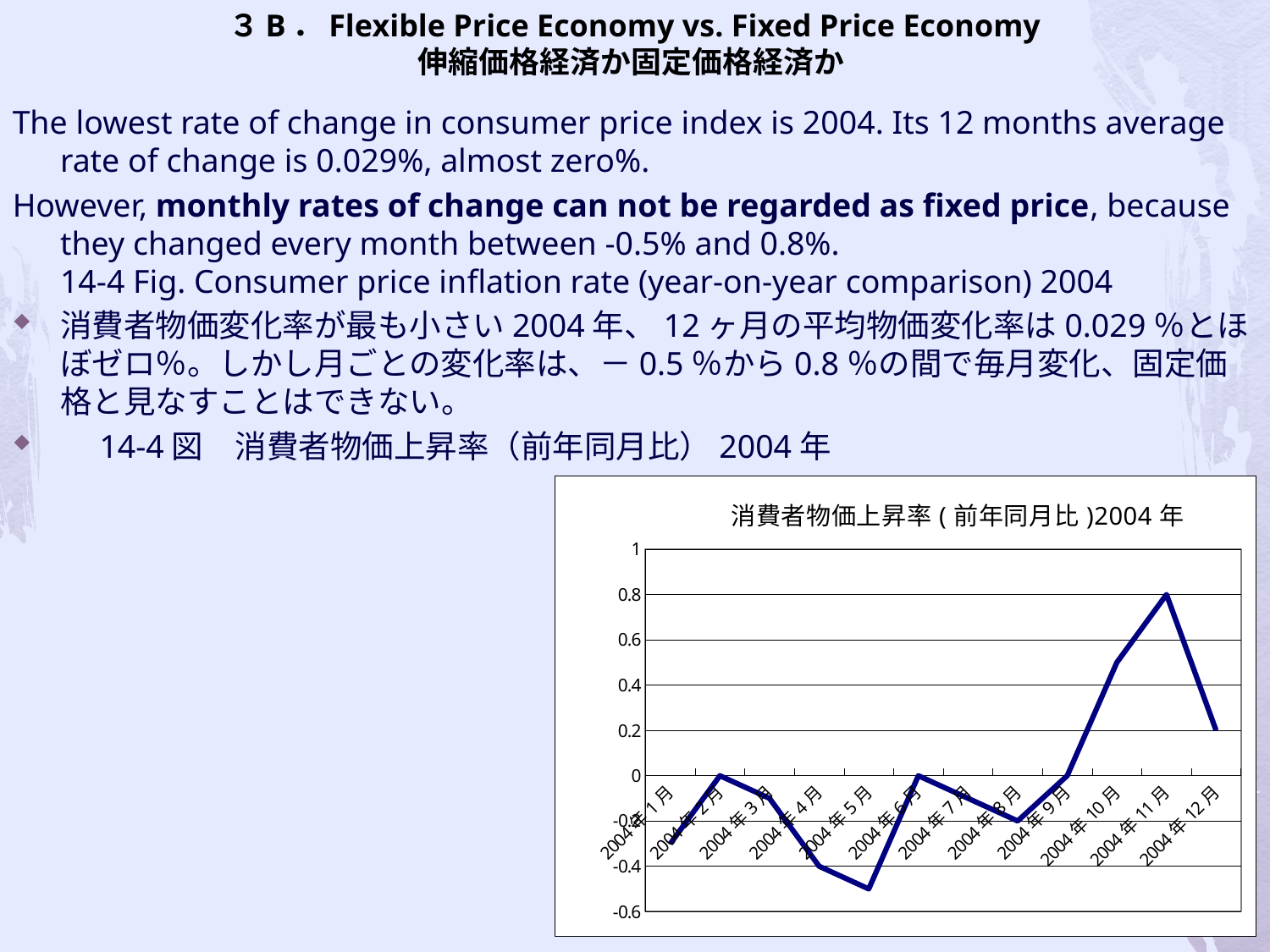
Do the values rise or fall from 2004年9月 to 2004年11月? rise What is the value for 2004年2月? 0 How many months (data points) are plotted on the chart? 12 Is the value for 2004年10月 greater or less than 0.4? greater What is the value for 2004年12月? 0.2 What kind of chart is shown on the slide? line chart Which month has the lowest value on the chart? 2004年5月 Is the value for 2004年5月 greater or less than -0.4? less What is the value for 2004年11月? 0.8 Which month has the highest value on the chart? 2004年11月 Which is larger, the value for 2004年11月 or the value for 2004年12月? 2004年11月 What is the title of the chart? 消費者物価上昇率(前年同月比)2004年